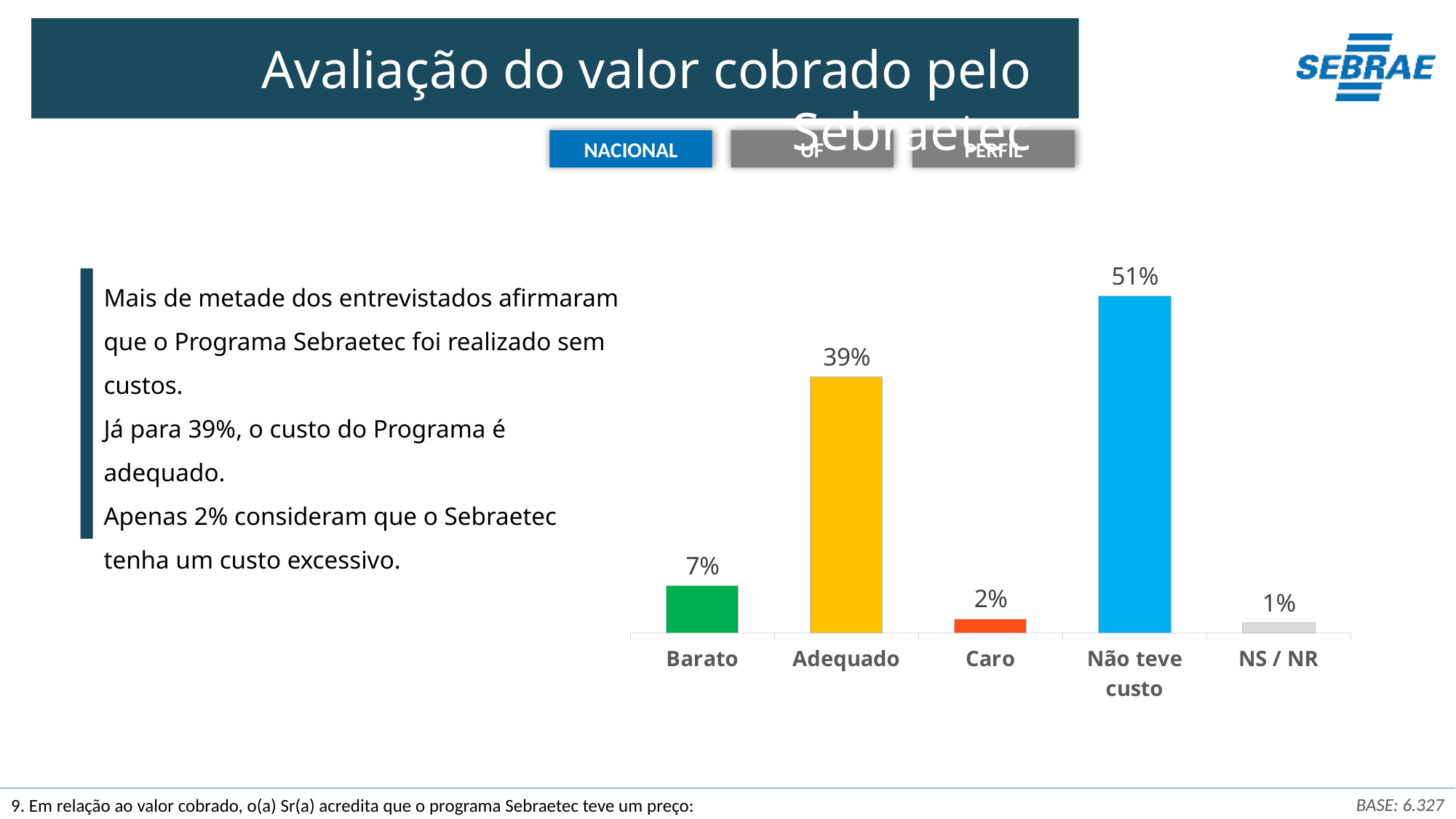
Which category has the lowest value? NS / NR What is the difference between the values for Não teve custo and Adequado? 12% Which is larger, the value for Barato or the value for Caro? Barato What is the value for Caro? 2% What colour is the bar for Adequado? Yellow How many categories are shown on the x axis? 5 What is the value for Não teve custo? 51% What is the value for Adequado? 39% What is the value for Barato? 7% Which category has the highest value? Não teve custo What kind of chart is shown on the slide? Bar chart What is the value for NS / NR? 1%